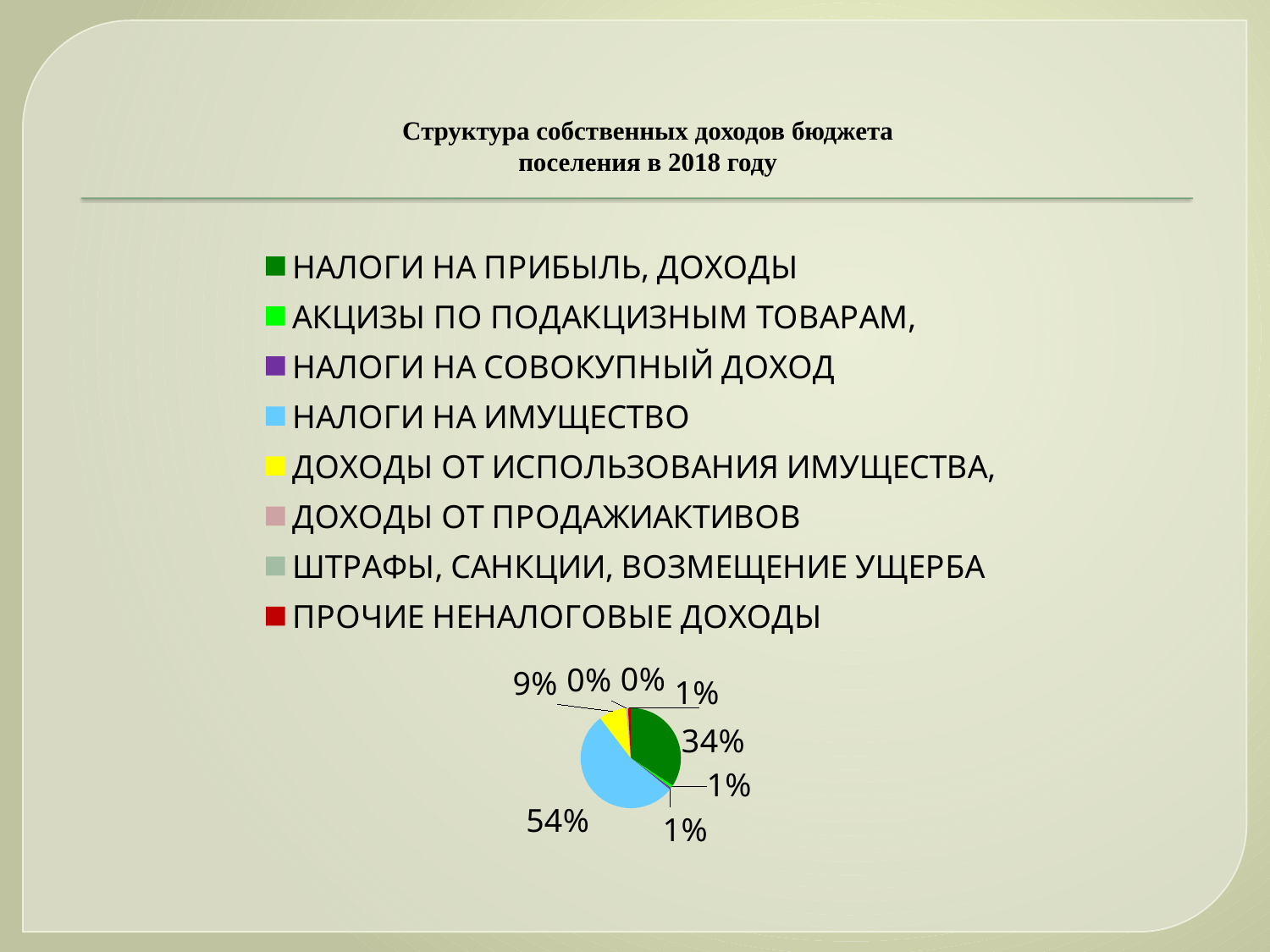
How many categories does the legend of the pie chart list? 8 What share of the pie does ДОХОДЫ ОТ ИСПОЛЬЗОВАНИЯ ИМУЩЕСТВА have? 9% What is the title of the chart on the slide? Структура собственных доходов бюджета поселения в 2018 году What share of the pie does НАЛОГИ НА ИМУЩЕСТВО have? 54% What is the difference in percentage points between the НАЛОГИ НА ИМУЩЕСТВО slice and the НАЛОГИ НА ПРИБЫЛЬ, ДОХОДЫ slice? 20 Which is larger: the slice for НАЛОГИ НА ПРИБЫЛЬ, ДОХОДЫ or the slice for ДОХОДЫ ОТ ИСПОЛЬЗОВАНИЯ ИМУЩЕСТВА? НАЛОГИ НА ПРИБЫЛЬ, ДОХОДЫ What kind of chart is shown on the slide? pie chart How many slices of the pie are labelled 0%? 2 What share of the pie does НАЛОГИ НА ПРИБЫЛЬ, ДОХОДЫ have? 34% What is the combined share of the НАЛОГИ НА ИМУЩЕСТВО and НАЛОГИ НА ПРИБЫЛЬ, ДОХОДЫ slices? 88% Which category has the largest slice of the pie? НАЛОГИ НА ИМУЩЕСТВО What colour is the slice for НАЛОГИ НА ИМУЩЕСТВО? light blue